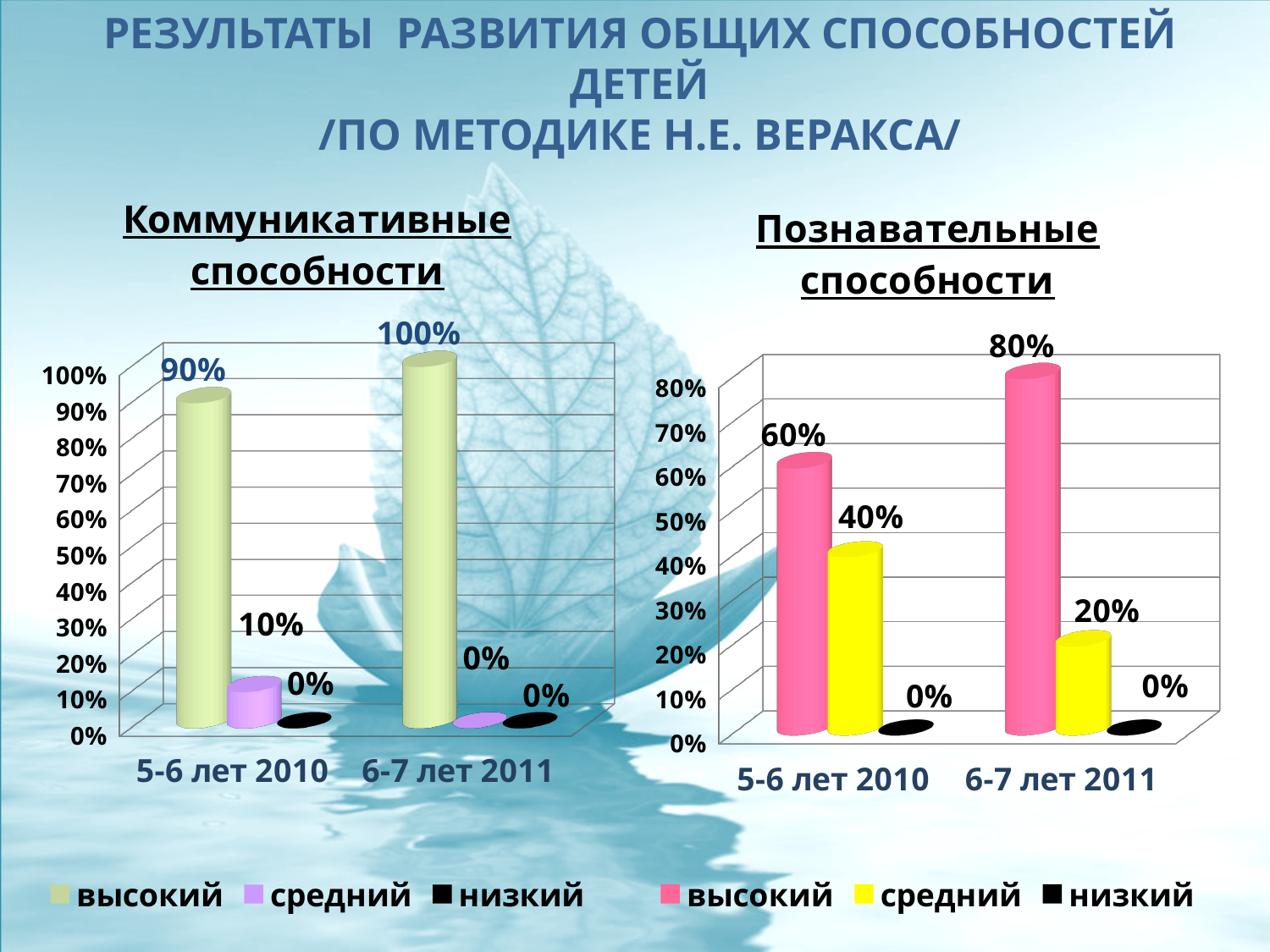
In the chart 'Познавательные способности', what is the value for 'средний' in '5-6 лет 2010'? 40% In the chart 'Коммуникативные способности', what is the value for 'средний' in '5-6 лет 2010'? 10% In the chart 'Коммуникативные способности', what is the value for 'высокий' in '5-6 лет 2010'? 90% In the chart 'Коммуникативные способности', which category has the higher 'высокий' value? 6-7 лет 2011 How many series does the legend of the chart 'Познавательные способности' list? 3 How many categories are shown on the x axis of the chart 'Коммуникативные способности'? 2 In the chart 'Познавательные способности', what is the difference between the 'высокий' values for '6-7 лет 2011' and '5-6 лет 2010'? 20% In the chart 'Познавательные способности', which is larger: 'высокий' in '5-6 лет 2010' or 'средний' in '5-6 лет 2010'? высокий in 5-6 лет 2010 In the chart 'Познавательные способности', what is the value for 'высокий' in '6-7 лет 2011'? 80% In the chart 'Коммуникативные способности', what is the value for 'высокий' in '6-7 лет 2011'? 100% In the chart 'Познавательные способности', what is the value for 'средний' in '6-7 лет 2011'? 20% What kind of chart is 'Познавательные способности'? Bar chart